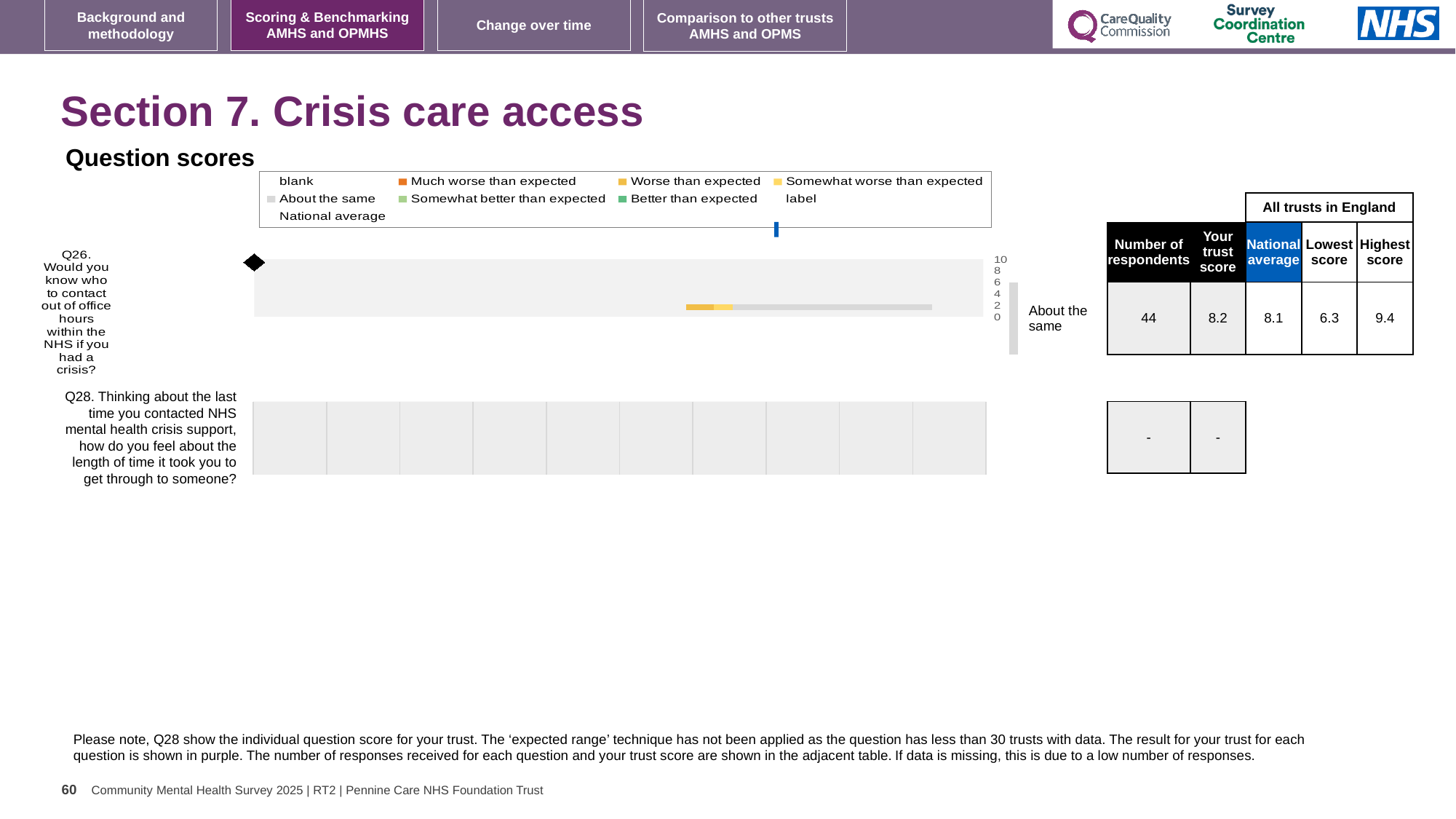
What is the title of the section shown on the slide? Section 7. Crisis care access How many questions are plotted in the Question scores chart? 2 What is the highest score among all trusts in England for Q26? 9.4 What benchmark category is shown next to the Q26 bar? About the same What is the lowest score among all trusts in England for Q26? 6.3 What is the trust score for Q26 (Would you know who to contact out of office hours within the NHS if you had a crisis?)? 8.2 What is the difference between the highest and lowest trust scores in England for Q26? 3.1 What is the national average score for Q26? 8.1 How many respondents answered Q26? 44 What is the trust score shown for Q28 in the table? - Is the trust score for Q26 higher or lower than the national average? higher What kind of chart is used for the Question scores? bar chart